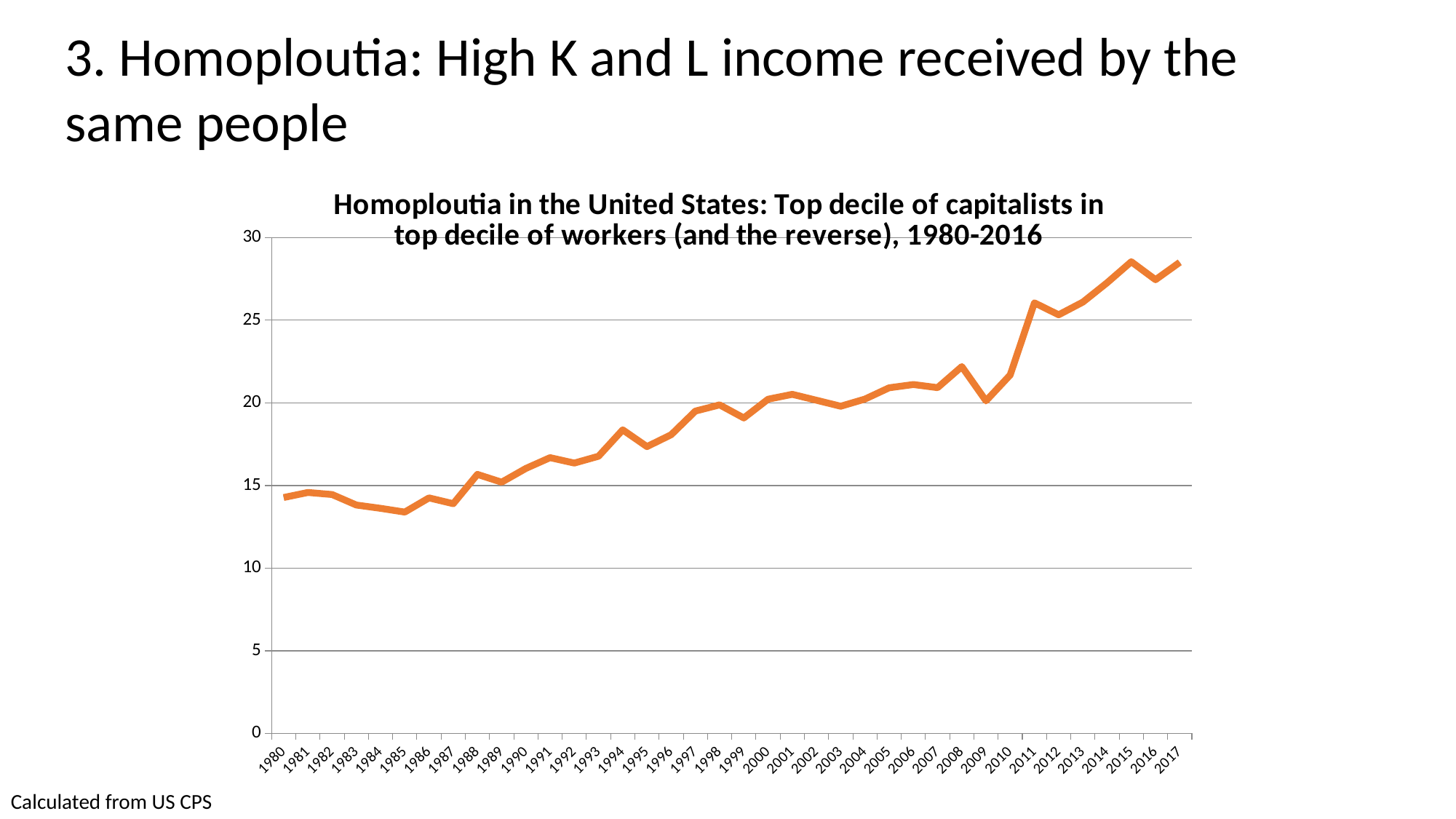
Is the value for 2015 greater or less than 25? greater What kind of chart is shown on the slide? line chart What is the source note shown at the bottom left of the slide? Calculated from US CPS Is the value for 2008 greater or less than 20? greater How many years are plotted along the x axis of the chart? 38 Which year has the larger value, 1980 or 2017? 2017 Overall, do the values rise or fall from 1980 to 2017? rise Which year has the larger value, 2009 or 2011? 2011 Which year has the lowest value on the chart? 1985 Is the value for 1994 greater or less than 20? less